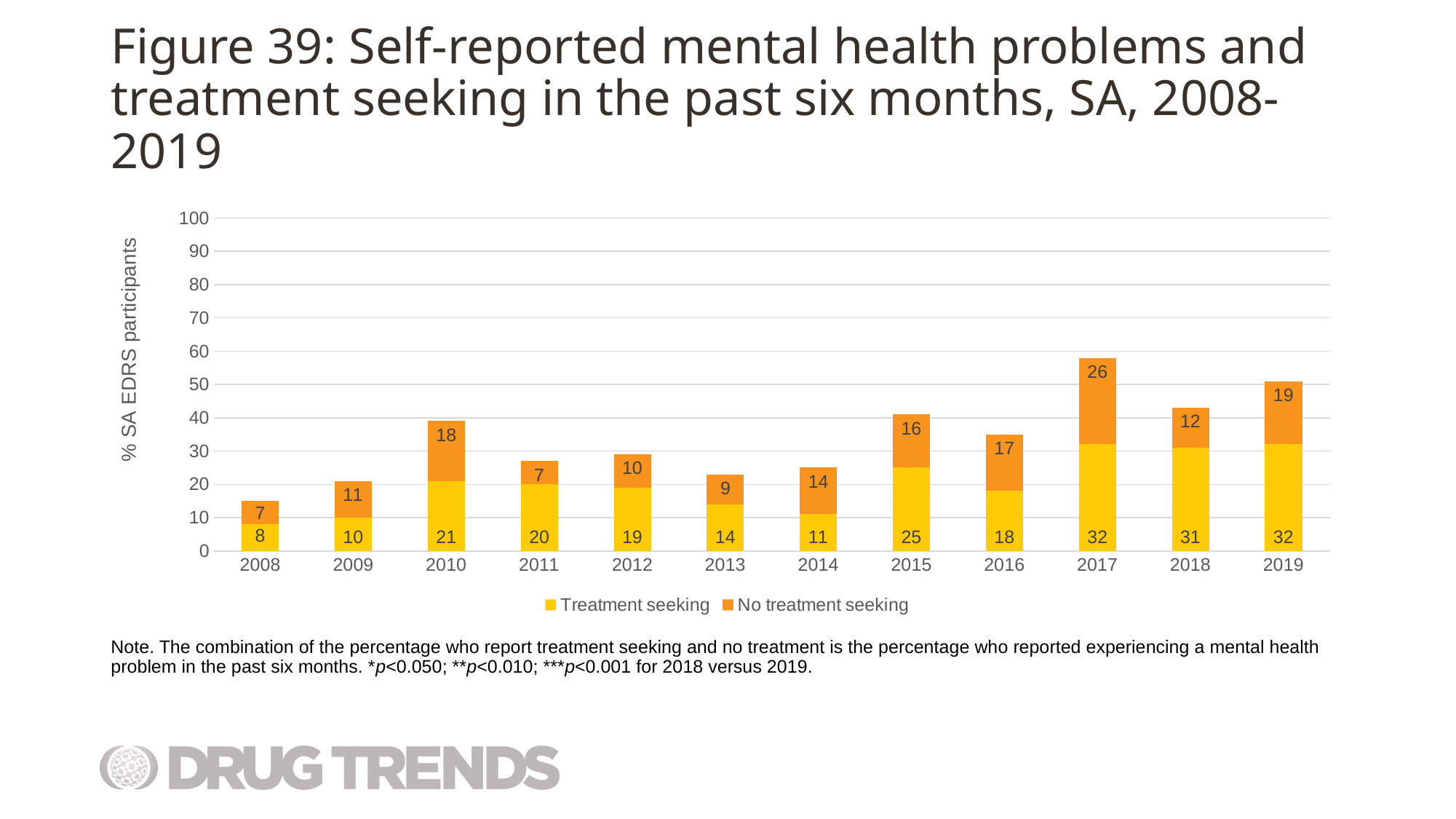
Which is larger, the No treatment seeking value for 2010 or for 2018? 2010 What is the difference between the Treatment seeking values for 2017 and 2016? 14 What is the value for No treatment seeking in 2017? 26 What is the total of the stacked bar for 2019? 51 What is the value for Treatment seeking in 2008? 8 How many years are shown on the x axis? 12 Which year has the highest value for No treatment seeking? 2017 How many series does the legend list? 2 What is the value for Treatment seeking in 2015? 25 Which year has the lowest value for Treatment seeking? 2008 What is the total of the stacked bar for 2013? 23 What kind of chart is shown on the slide? Stacked bar chart